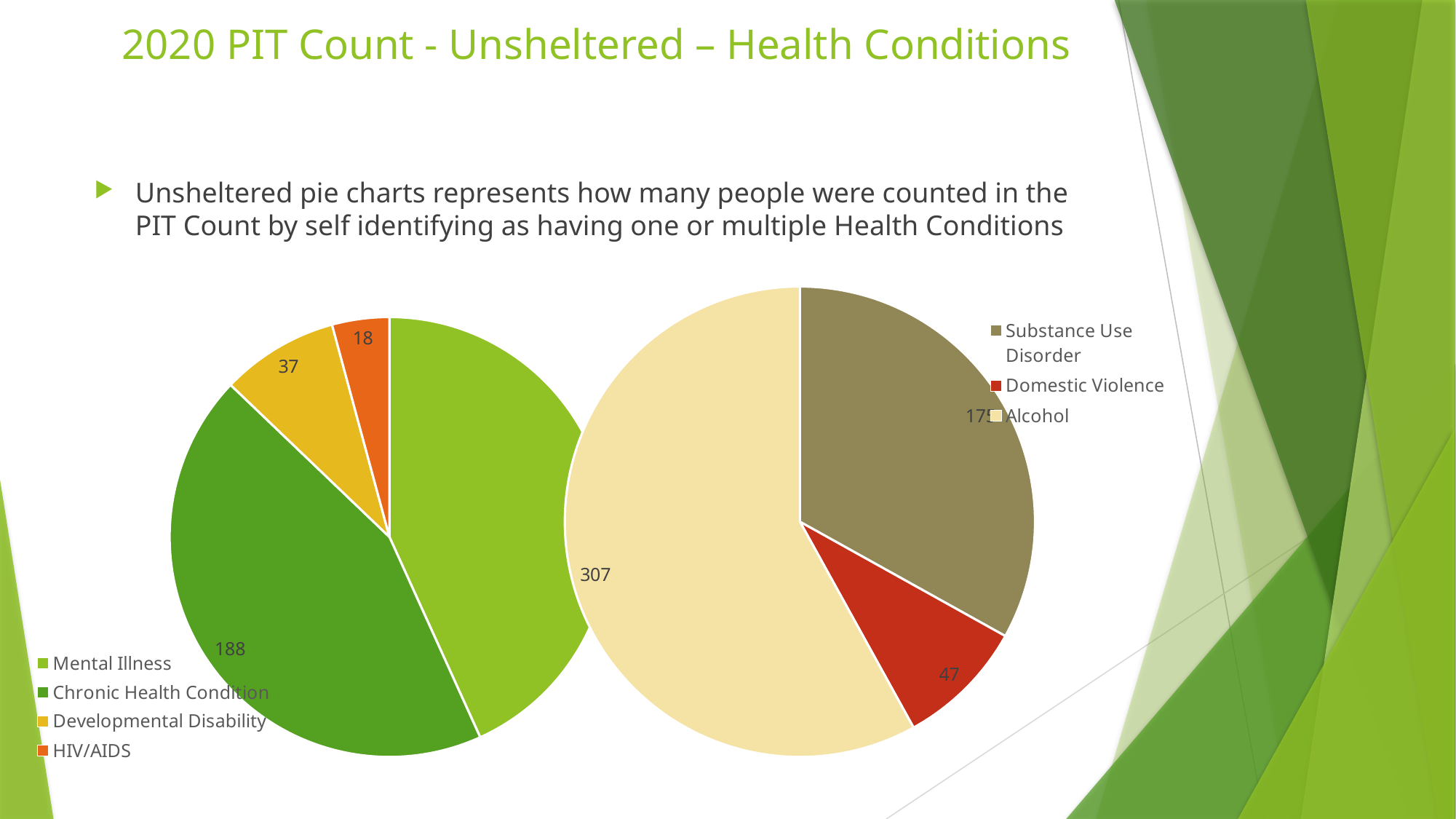
In the right pie chart, which category has the largest slice? Alcohol What kind of chart is used on this slide? Pie chart In the right pie chart, what is the difference between the Alcohol value and the Domestic Violence value? 260 In the right pie chart, what is the value for Alcohol? 307 In the right pie chart, which category has the smallest slice? Domestic Violence In the left pie chart, what is the value for HIV/AIDS? 18 How many categories does the legend of the left pie chart list? 4 In the left pie chart, what is the value for Developmental Disability? 37 In the left pie chart, what is the value for Chronic Health Condition? 188 In the right pie chart, what is the value for Domestic Violence? 47 In the left pie chart, which category has the smallest slice? HIV/AIDS